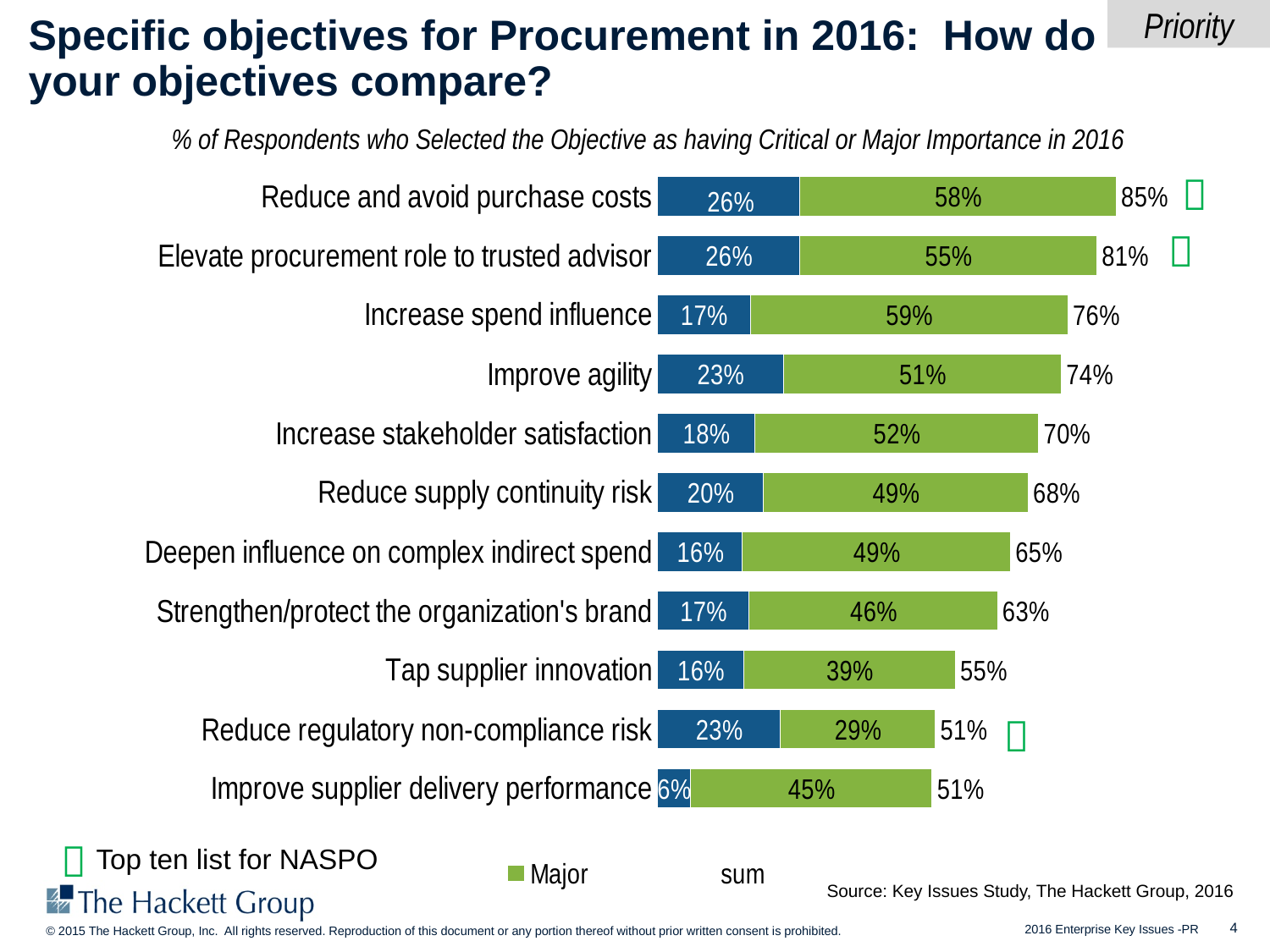
What is the difference between the sum values for "Reduce and avoid purchase costs" and "Elevate procurement role to trusted advisor"? 4 percentage points Which objective has the highest Major value? Increase spend influence Which has a larger Major value: "Improve agility" or "Increase stakeholder satisfaction"? Increase stakeholder satisfaction What is the Major value for "Tap supplier innovation"? 39% How many objectives are listed in the chart? 11 According to the key at the bottom left, what does the green check mark next to a bar indicate? Top ten list for NASPO What is the total (sum) value shown for "Increase spend influence"? 76% What type of chart is shown on the slide? Stacked bar chart Which objective has the highest sum value? Reduce and avoid purchase costs What value is shown in the blue segment for "Improve supplier delivery performance"? 6% What is the total of the stacked bar for "Improve agility"? 74% Which objective has the smallest blue segment value? Improve supplier delivery performance